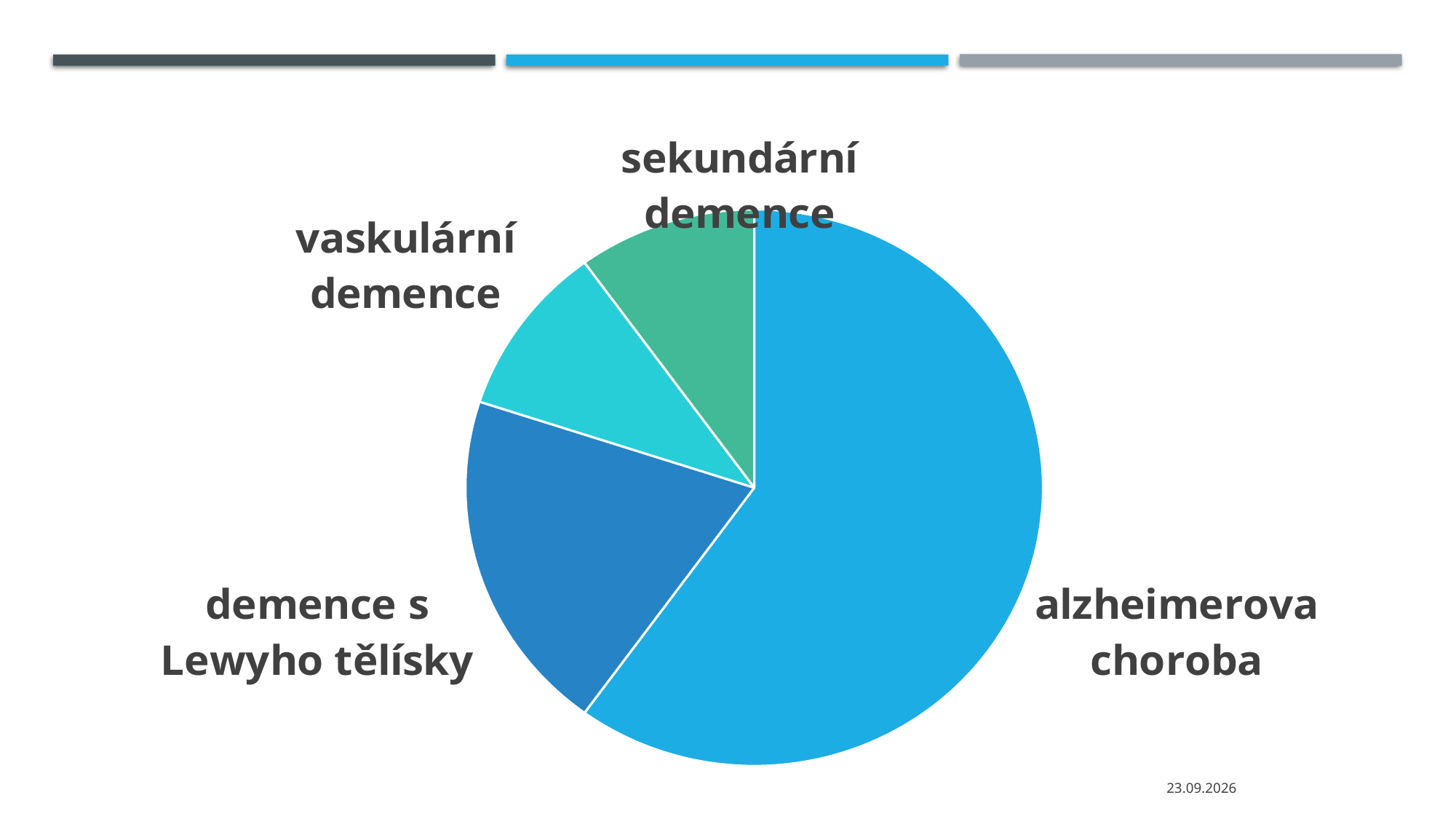
Which category has the largest slice of the pie chart? alzheimerova choroba Which slice is larger, sekundární demence or alzheimerova choroba? alzheimerova choroba Which slice is larger, demence s Lewyho tělísky or sekundární demence? demence s Lewyho tělísky Which slice is larger, demence s Lewyho tělísky or vaskulární demence? demence s Lewyho tělísky Which category label appears at the top of the pie chart? sekundární demence How many slices does the pie chart have? 4 What kind of chart is shown on the slide? pie chart Which category has the second-largest slice of the pie chart? demence s Lewyho tělísky What colour is the alzheimerova choroba slice? light blue